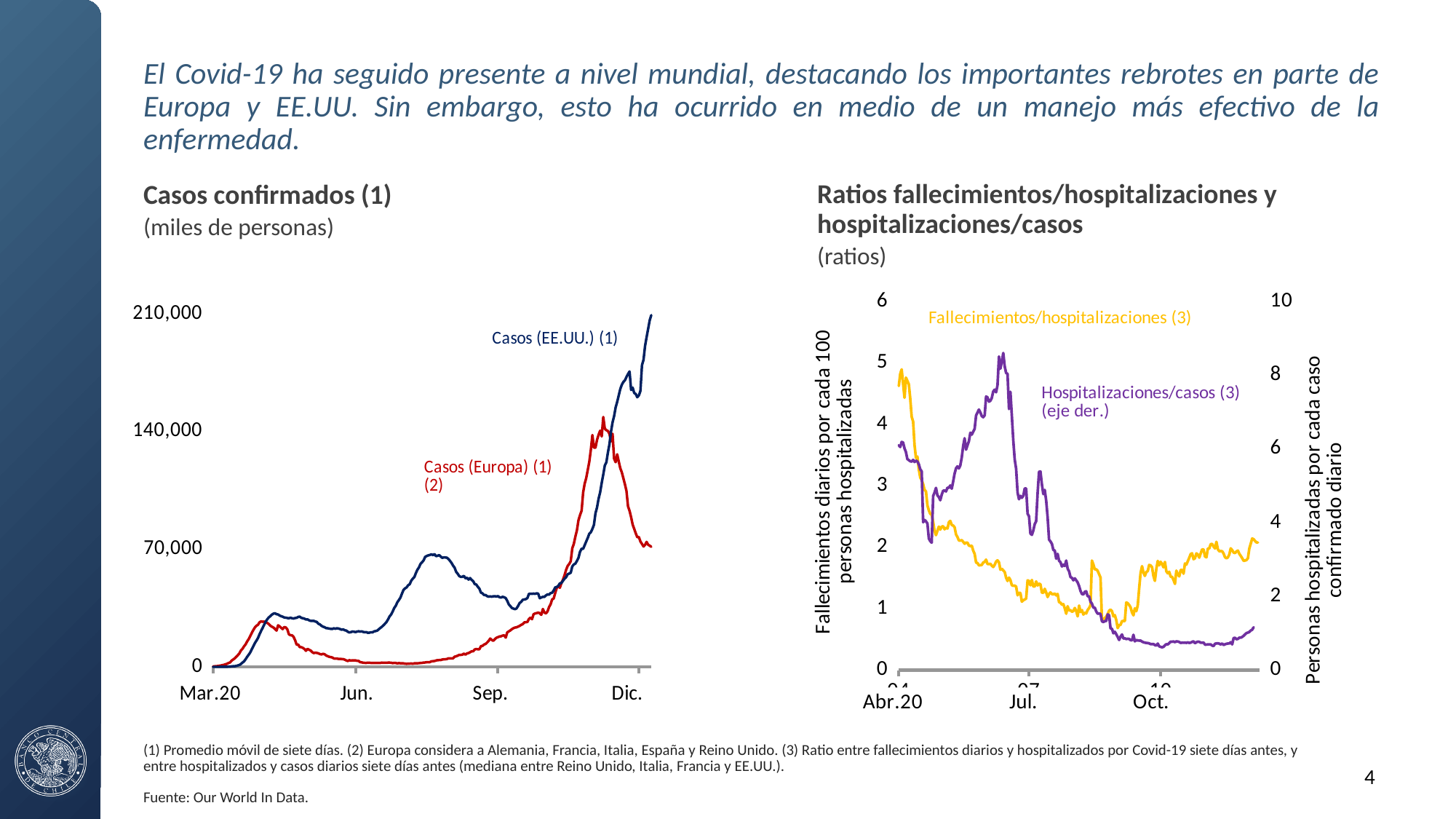
In the left chart 'Casos confirmados (1)', is the value of Casos (EE.UU.) at Jun. greater or less than 70,000? less In the right chart, is the value of Hospitalizaciones/casos at Oct. (right axis) greater or less than 2? less In the left chart 'Casos confirmados (1)', at the end of the series (Dic.), which is larger: Casos (EE.UU.) or Casos (Europa)? Casos (EE.UU.) In the left chart 'Casos confirmados (1)', is the value of Casos (EE.UU.) at the end of the series (Dic.) greater or less than 140,000? greater In the left chart 'Casos confirmados (1)', do the Casos (EE.UU.) values rise or fall between Sep. and Dic.? rise In the left chart 'Casos confirmados (1)', what unit is given under the title? miles de personas In the right chart, does the Fallecimientos/hospitalizaciones series rise or fall overall between Abr.20 and Oct.? fall In the right chart 'Ratios fallecimientos/hospitalizaciones y hospitalizaciones/casos', how many series are plotted? 2 In the left chart 'Casos confirmados (1)', how many series are plotted? 2 What kind of chart is the left chart titled 'Casos confirmados (1)'? line chart What kind of chart is the right chart titled 'Ratios fallecimientos/hospitalizaciones y hospitalizaciones/casos'? line chart